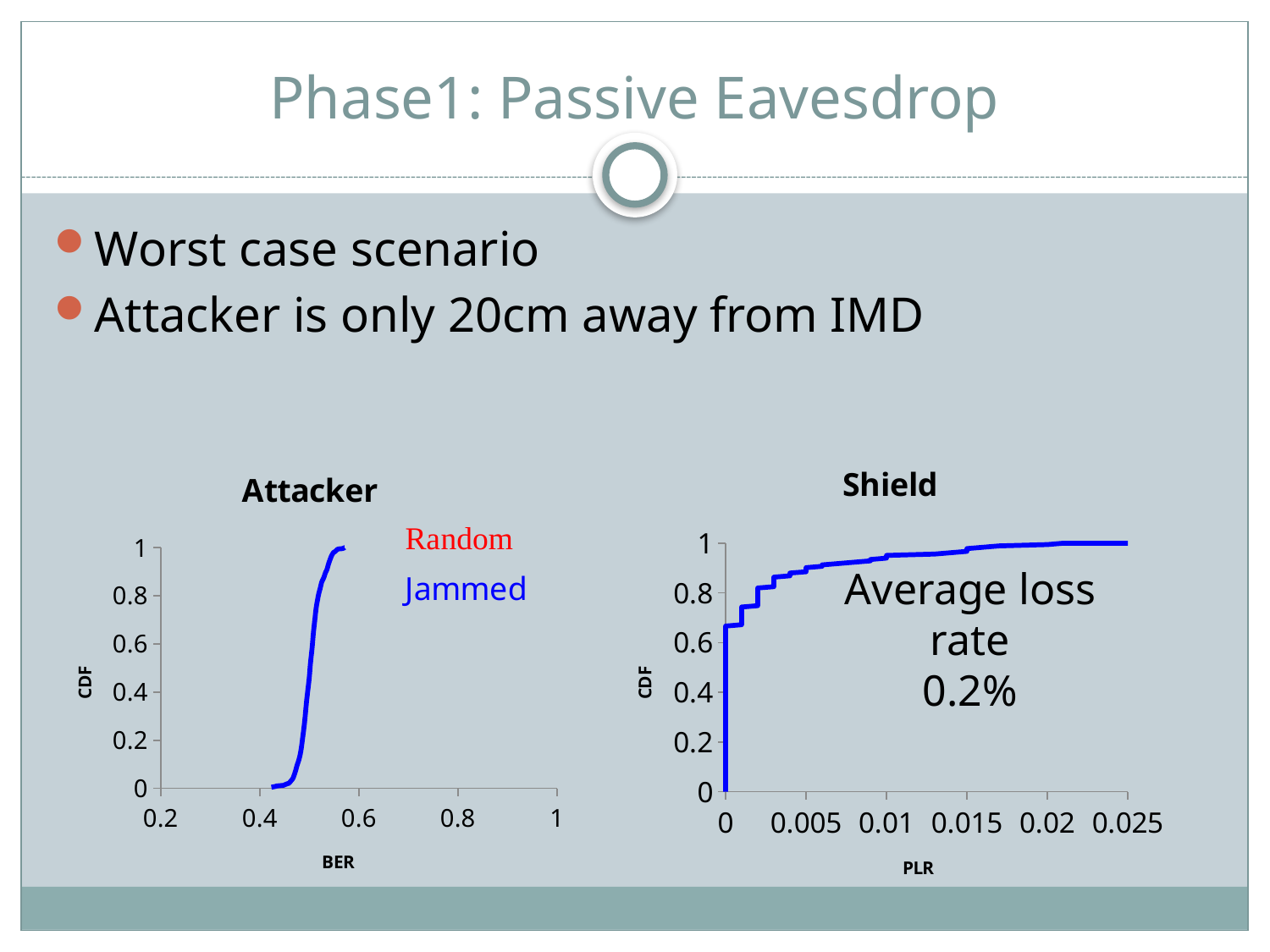
In the Attacker chart, does the CDF rise or fall as BER increases? rise In the Attacker chart, what are the two legend entries? Random and Jammed What is the x-axis label of the Attacker chart? BER What kind of chart is the Shield chart? line chart In the Shield chart, is the CDF value at PLR 0.005 greater or less than 0.8? greater What kind of chart is the Attacker chart? line chart In the Attacker chart, is the CDF value at BER 0.45 greater or less than 0.2? less In the Attacker chart, is the CDF value at BER 0.55 greater or less than 0.8? greater In the Shield chart, does the CDF rise or fall as PLR increases? rise In the Attacker chart, how many series does the legend list? 2